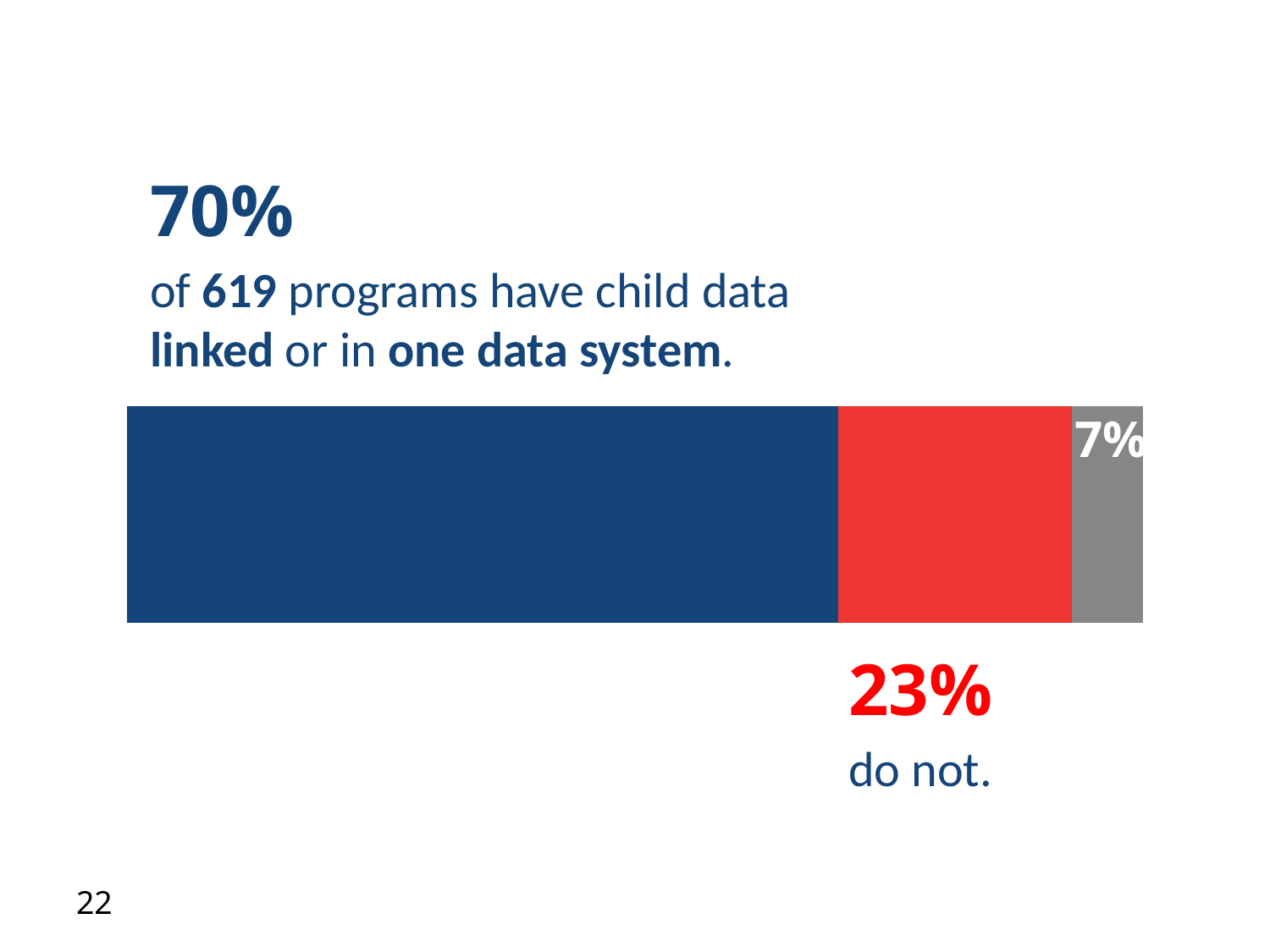
What value is printed on the gray segment at the right end of the bar? 7% Which segment of the bar represents the smallest share? The gray segment (7%) What kind of chart is shown on the slide? A stacked horizontal bar chart Which is larger: the share of programs that have child data linked or in one data system, or the share that do not? The share that have child data linked or in one data system (70%) What percentage of 619 programs have child data linked or in one data system, according to the blue segment of the bar? 70% Which segment of the bar represents the largest share? The blue segment (70%) What colour is the segment representing the 23% of programs that do not have child data linked or in one data system? Red What percentage of programs do not have child data linked or in one data system, as shown by the red segment? 23% How many segments make up the stacked bar? 3 What is the difference in percentage points between the programs that have child data linked or in one data system (70%) and those that do not (23%)? 47 percentage points What is the total of the three segments in the stacked bar (70%, 23% and 7%)? 100% How many programs does the slide say the percentages are based on? 619